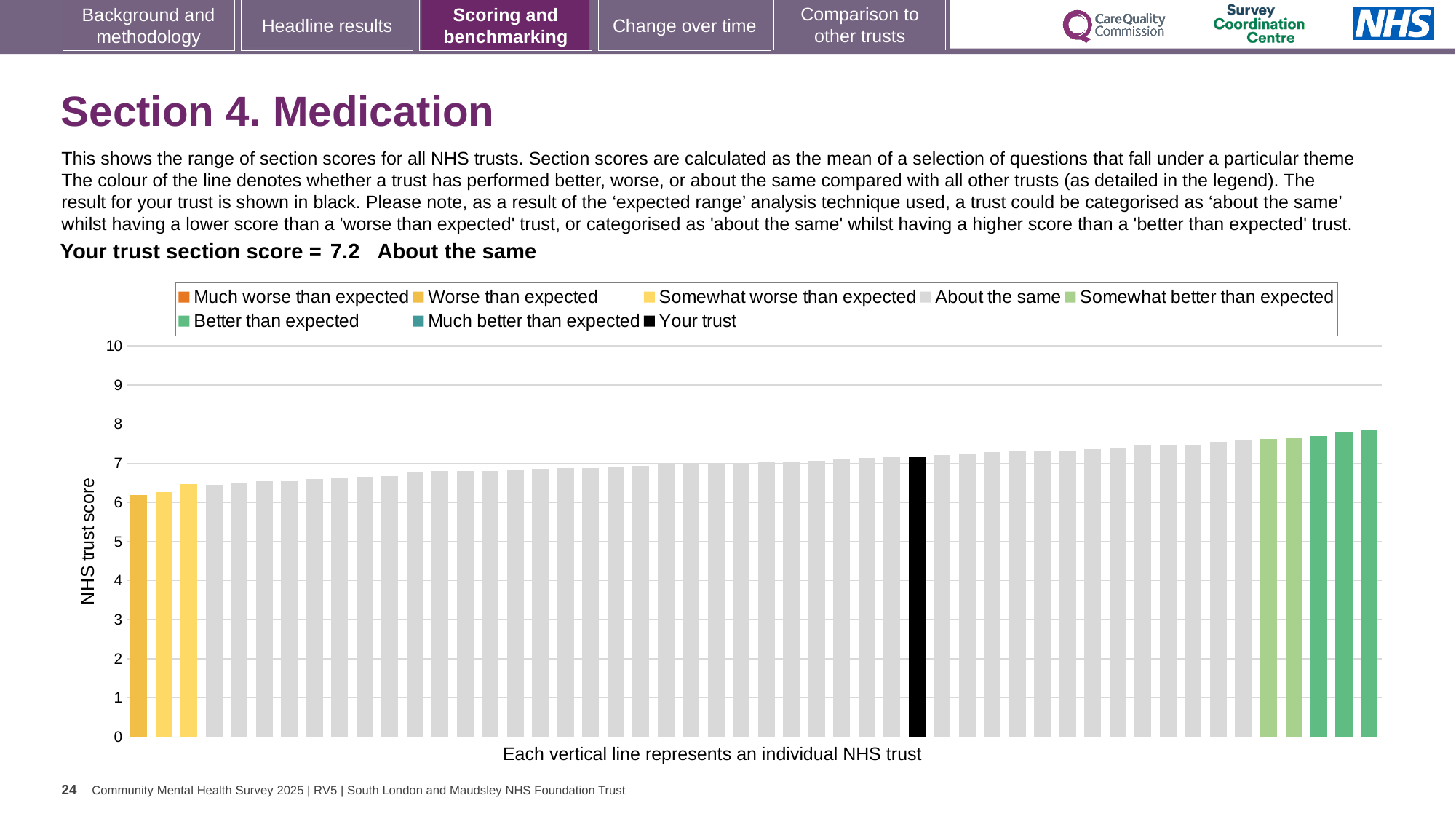
Which performance category is your trust placed in for Section 4. Medication? About the same Which legend category does the lowest bar in the chart belong to? Worse than expected What is the label on the vertical axis of the chart? NHS trust score How many entries does the chart legend list? 8 Which legend category does the highest bar in the chart belong to? Better than expected Do the bar values rise or fall from left to right along the x axis? Rise Is the value of the black 'Your trust' bar greater or less than 7? greater Is the value of the highest bar in the chart greater or less than 8? less What kind of chart is shown on the slide? Bar chart What colour is the bar representing your trust? Black What is the section score for your trust shown on the slide? 7.2 Is the value of the lowest bar in the chart greater or less than 7? less